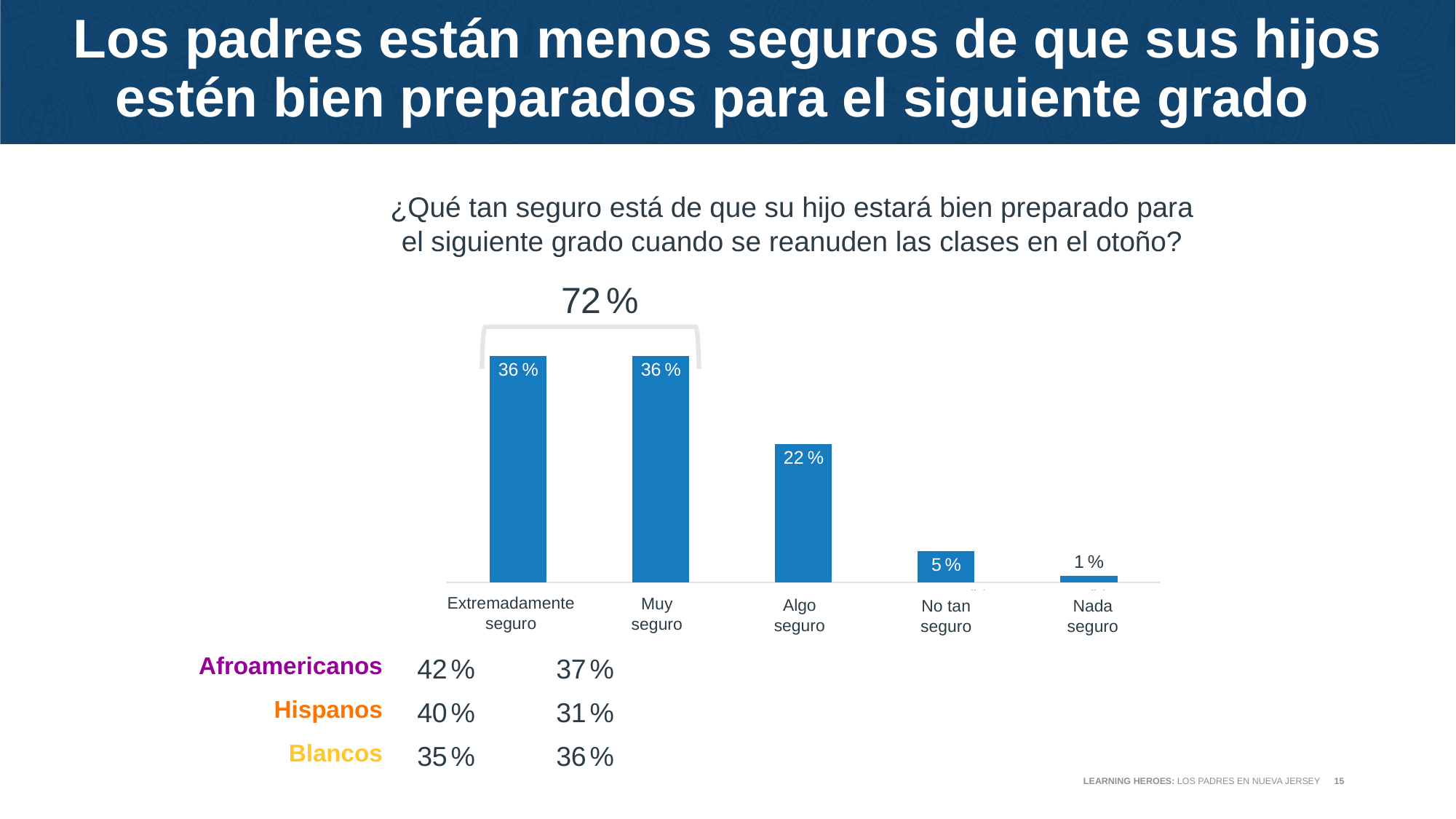
What kind of chart is shown on the slide? Bar chart What combined percentage is shown by the bracket above the "Extremadamente seguro" and "Muy seguro" bars? 72 % What is the value for "Algo seguro"? 22 % What is the value for "Nada seguro"? 1 % What is the value for "Muy seguro"? 36 % What is the "Extremadamente seguro" value shown for Hispanos below the chart? 40 % Which category has the lowest value? Nada seguro Do the values rise or fall from left to right along the x axis? Fall Which is larger, the value for "Algo seguro" or the value for "No tan seguro"? Algo seguro How many categories are shown on the x axis? 5 What is the difference between the values for "Algo seguro" and "No tan seguro"? 17 % What is the value for "No tan seguro"? 5 %